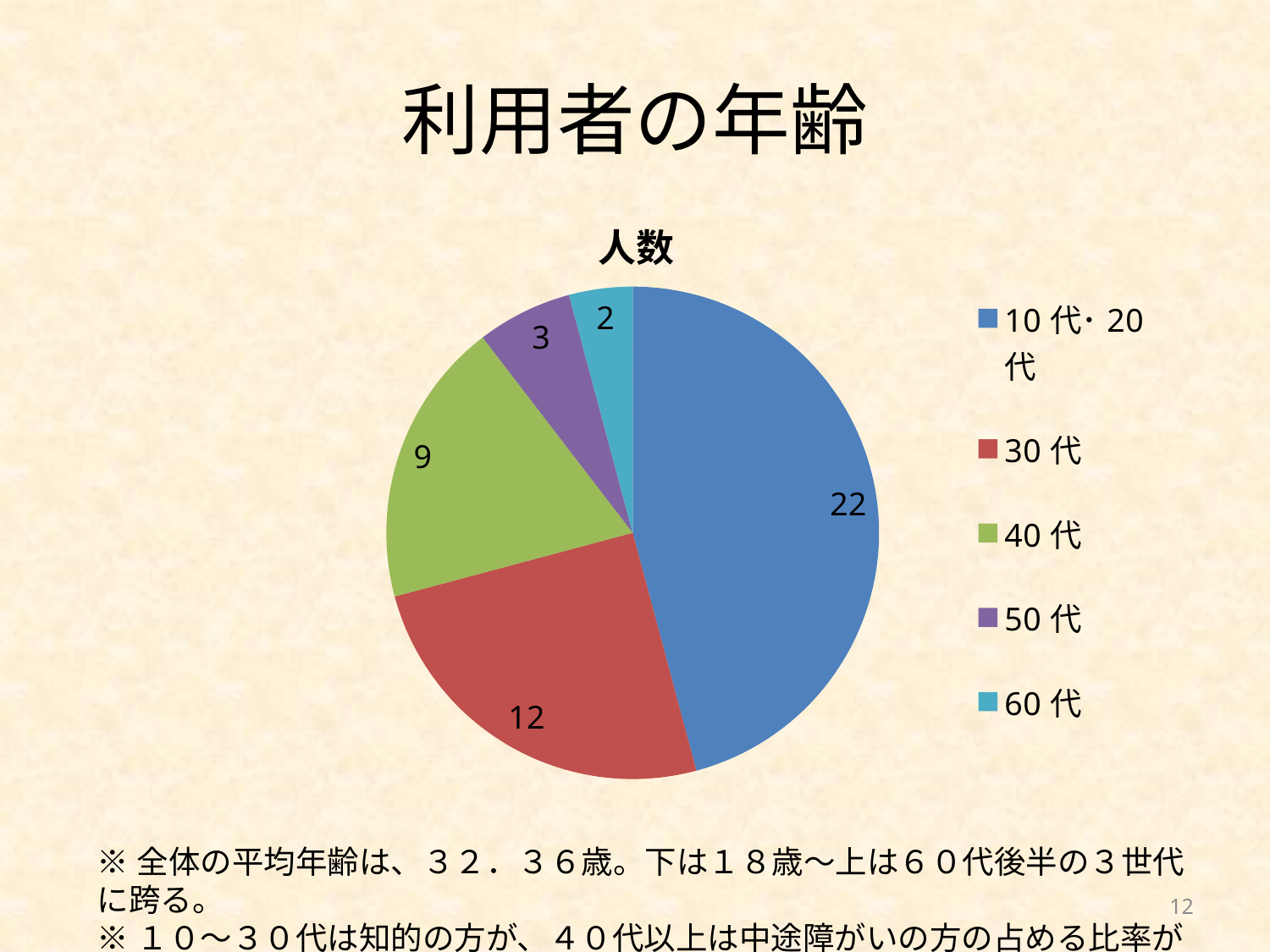
Which is larger, the value for 40代 or the value for 50代? 40代 Which age group has the smallest slice? 60代 What is the value for 30代? 12 What kind of chart is shown on the slide? Pie chart What is the value for 40代? 9 What share of the total does the 30代 slice represent? 25% What is the title of the chart? 人数 What is the difference between the values for 10代・20代 and 30代? 10 How many categories does the legend list? 5 What is the value for 60代? 2 Which age group has the largest slice? 10代・20代 What is the value for 10代・20代? 22